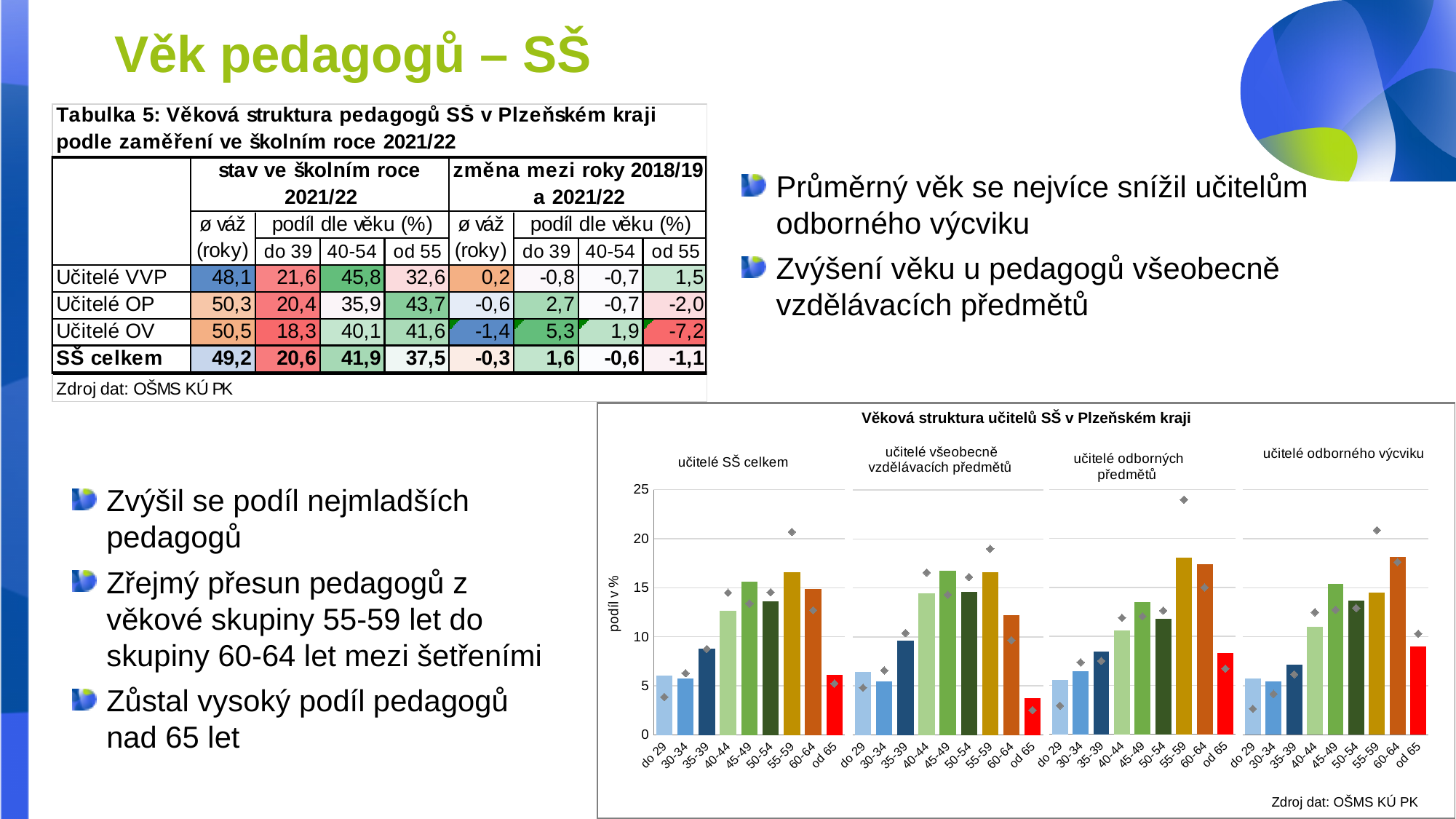
What is the label of the vertical axis of the chart? podíl v % In the 'učitelé odborných předmětů' panel of the chart, which age group has the lowest bar? do 29 How many age-group categories are shown in the 'učitelé SŠ celkem' panel of the chart? 9 In the 'učitelé SŠ celkem' panel of the chart, is the value for 35-39 greater or less than 10? less In the 'učitelé SŠ celkem' panel of the chart, which age group has the highest bar? 55-59 What kind of chart is shown on the slide? bar chart In the 'učitelé SŠ celkem' panel of the chart, which bar is taller: 40-44 or 45-49? 45-49 What is the title of the chart on the slide? Věková struktura učitelů SŠ v Plzeňském kraji In the 'učitelé všeobecně vzdělávacích předmětů' panel of the chart, which age group has the lowest bar? od 65 In the 'učitelé SŠ celkem' panel of the chart, is the value for 55-59 greater or less than 15? greater In the 'učitelé odborných předmětů' panel of the chart, is the value for od 65 greater or less than 5? greater In the 'učitelé odborného výcviku' panel of the chart, which age group has the highest bar? 60-64